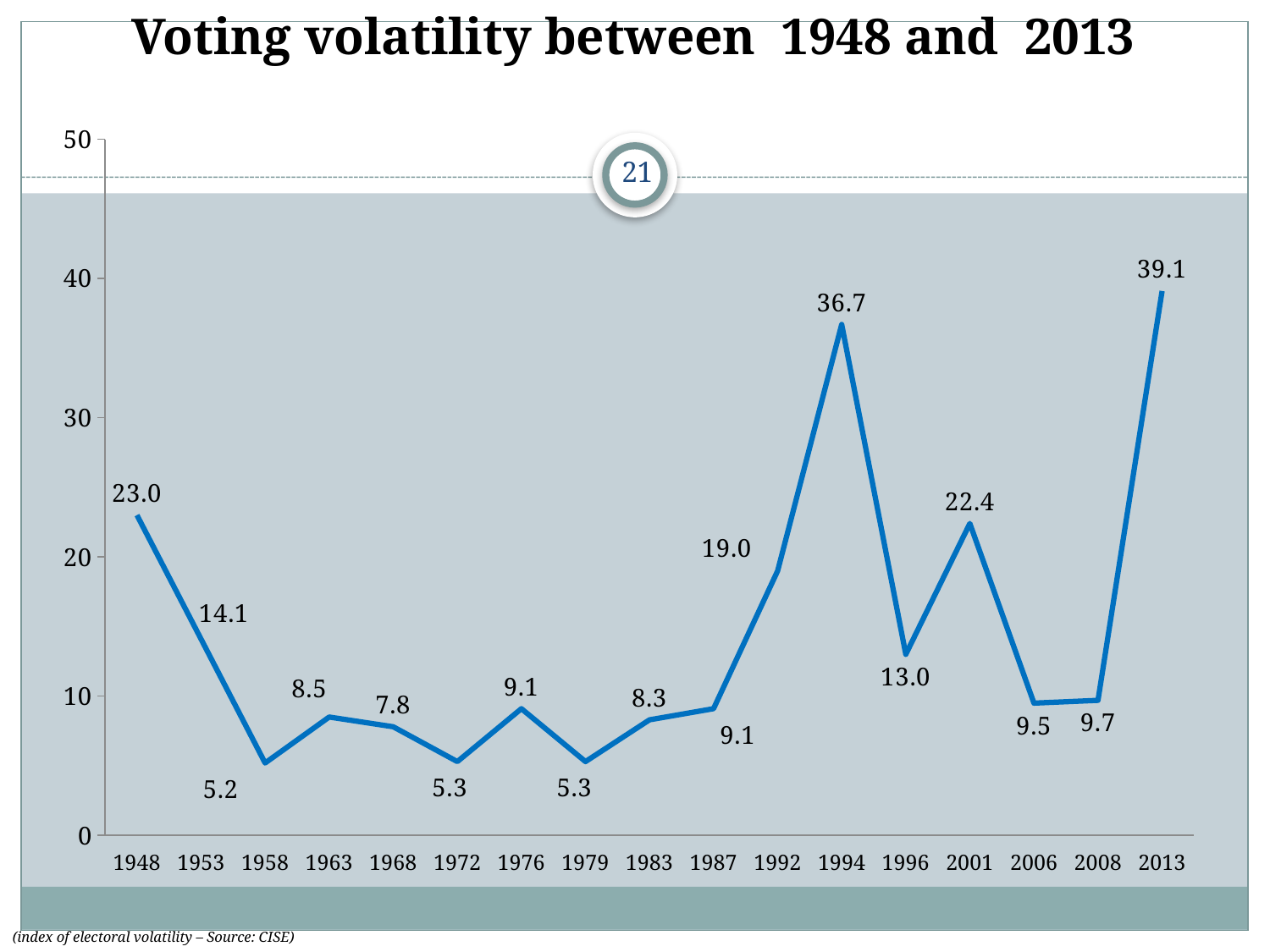
What is the difference between the voting volatility in 1948 and in 1953? 8.9 What kind of chart is shown on the slide? line chart How many years are plotted on the chart? 17 Does the voting volatility rise or fall from 1948 to 1958? fall What is the voting volatility value for 1948? 23.0 Which year has the highest voting volatility? 2013 What is the voting volatility value for 1994? 36.7 What is the voting volatility value for 2001? 22.4 What is the difference between the voting volatility in 2013 and in 1994? 2.4 Is the voting volatility for 1996 greater or less than 20? less Which year has the larger voting volatility, 1994 or 2001? 1994 What is the voting volatility value for 1992? 19.0